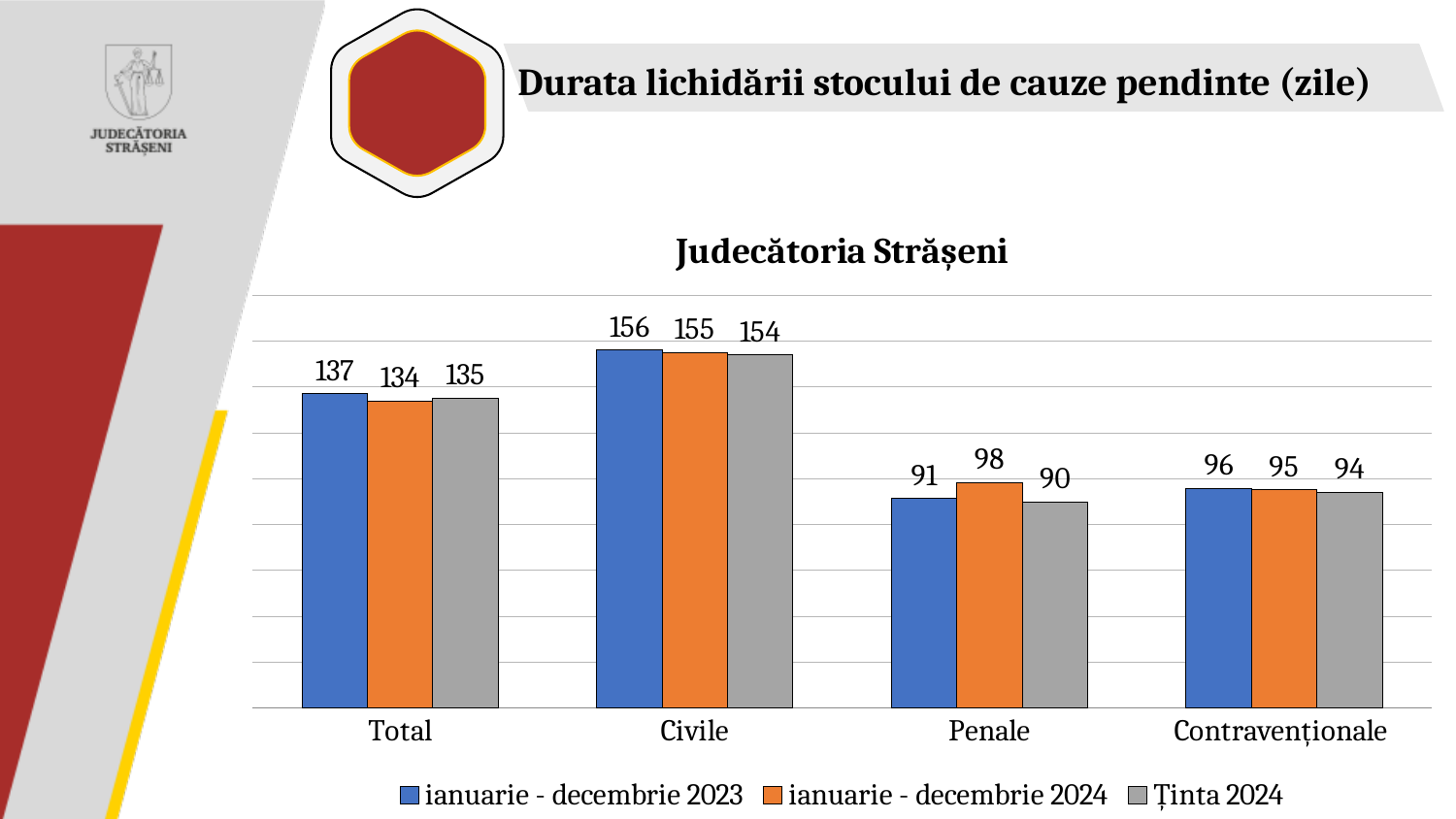
What is the value for Civile in the ianuarie - decembrie 2023 series? 156 How many categories are shown on the x axis? 4 What kind of chart is shown on the slide? Bar chart What is the value for Penale in the ianuarie - decembrie 2024 series? 98 Which is larger for Penale: the ianuarie - decembrie 2024 value or the Ținta 2024 value? ianuarie - decembrie 2024 Which category has the highest value in the ianuarie - decembrie 2023 series? Civile How many series does the legend list? 3 What is the value for Total in the ianuarie - decembrie 2024 series? 134 Which category has the lowest value in the Ținta 2024 series? Penale What is the Ținta 2024 value for Contravenționale? 94 What is the difference between the ianuarie - decembrie 2023 and ianuarie - decembrie 2024 values for Total? 3 What is the difference between the ianuarie - decembrie 2024 value and the Ținta 2024 value for Penale? 8